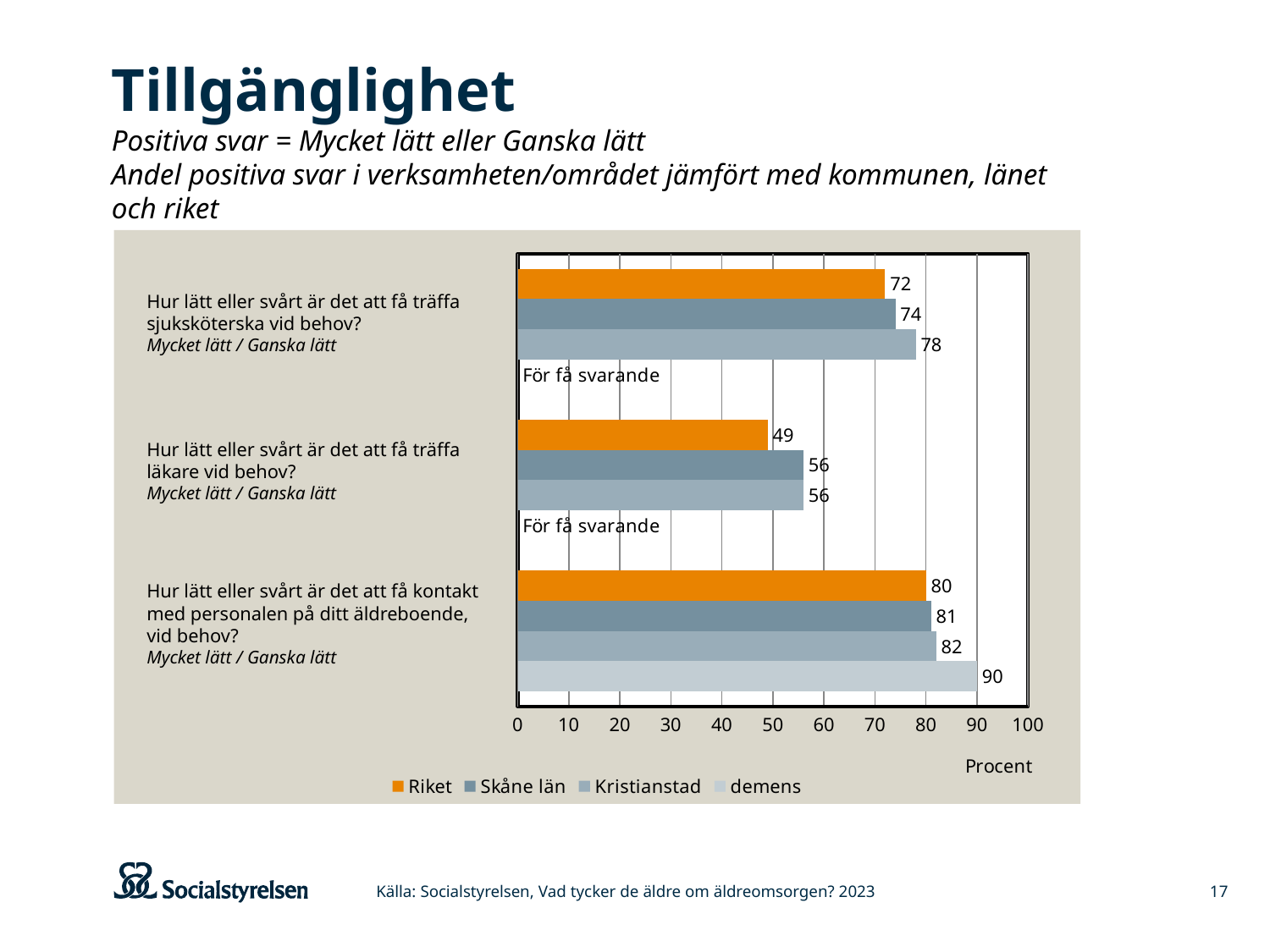
Which series has the lowest value on the question about how easy it is to meet a doctor (läkare)? Riket What is the difference between the Kristianstad and Riket values on the question about meeting a nurse (sjuksköterska)? 6 What type of chart is shown on the slide? Bar chart Which series has the highest value on the question about getting in contact with staff at the care home? demens How many series does the legend list? 4 What is the value for demens on the question about getting in contact with staff at the care home when needed? 90 What is shown for the demens series on the question about meeting a doctor (läkare) when needed? För få svarande What is the value for Riket on the question about how easy it is to meet a nurse (sjuksköterska) when needed? 72 What is the label on the horizontal axis of the chart? Procent What is the value for Skåne län on the question about getting in contact with staff at the care home when needed? 81 What is the value for Kristianstad on the question about how easy it is to meet a doctor (läkare) when needed? 56 Which is larger on the question about meeting a doctor (läkare): the value for Riket or the value for Skåne län? Skåne län